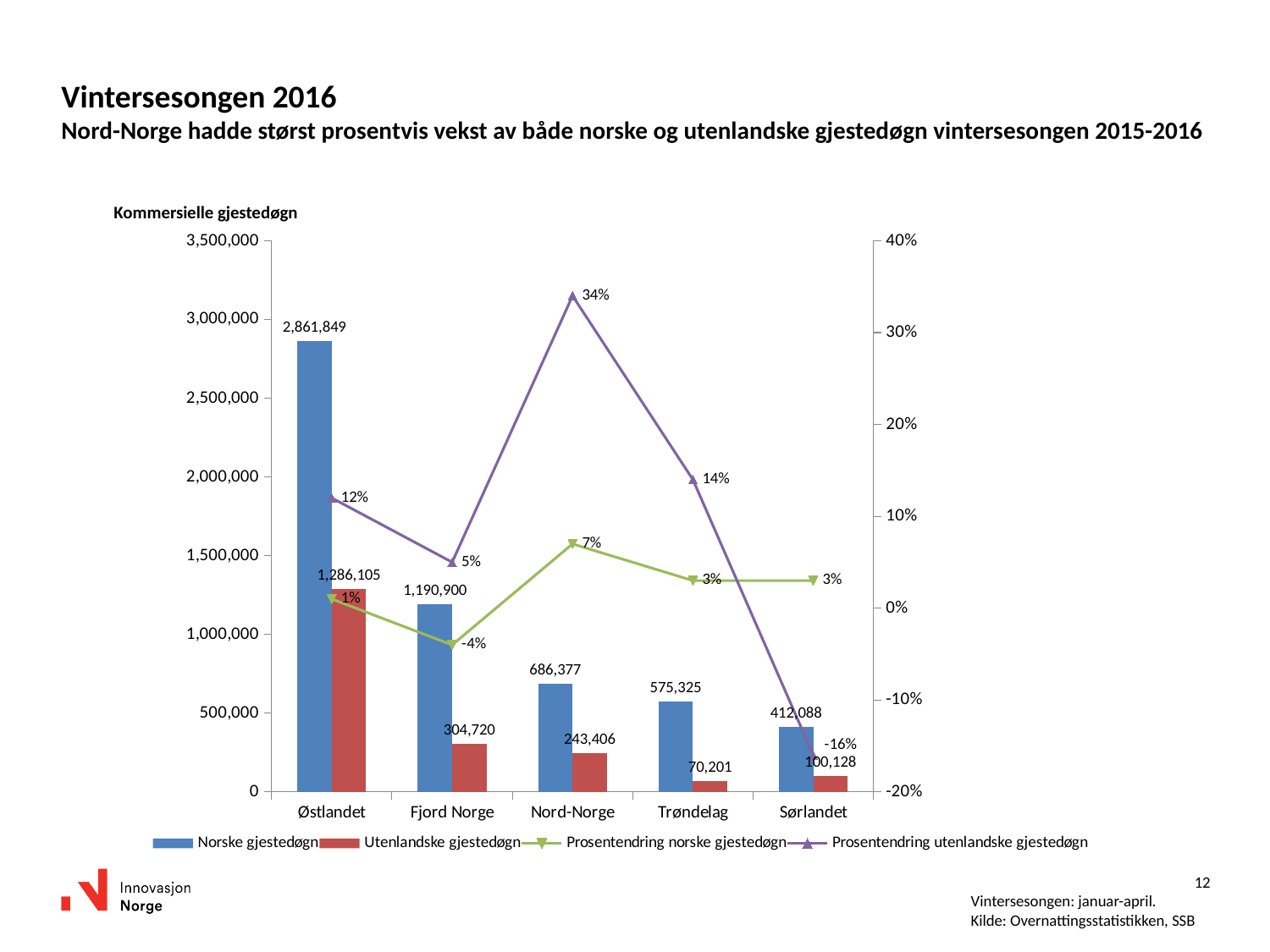
Does the Norske gjestedøgn series rise or fall from Østlandet to Sørlandet? fall How many series does the legend list? 4 What is the title shown above the chart? Kommersielle gjestedøgn What is the value of Utenlandske gjestedøgn for Fjord Norge? 304,720 What is the value of Norske gjestedøgn for Østlandet? 2,861,849 What is the difference between Norske gjestedøgn and Utenlandske gjestedøgn for Nord-Norge? 442,971 Which is larger for Sørlandet: Norske gjestedøgn or Utenlandske gjestedøgn? Norske gjestedøgn How many regions are shown on the x axis? 5 Which region has the highest Prosentendring utenlandske gjestedøgn? Nord-Norge What is the Prosentendring utenlandske gjestedøgn for Nord-Norge? 34% Which region has the lowest value of Utenlandske gjestedøgn? Trøndelag What is the Prosentendring norske gjestedøgn for Fjord Norge? -4%